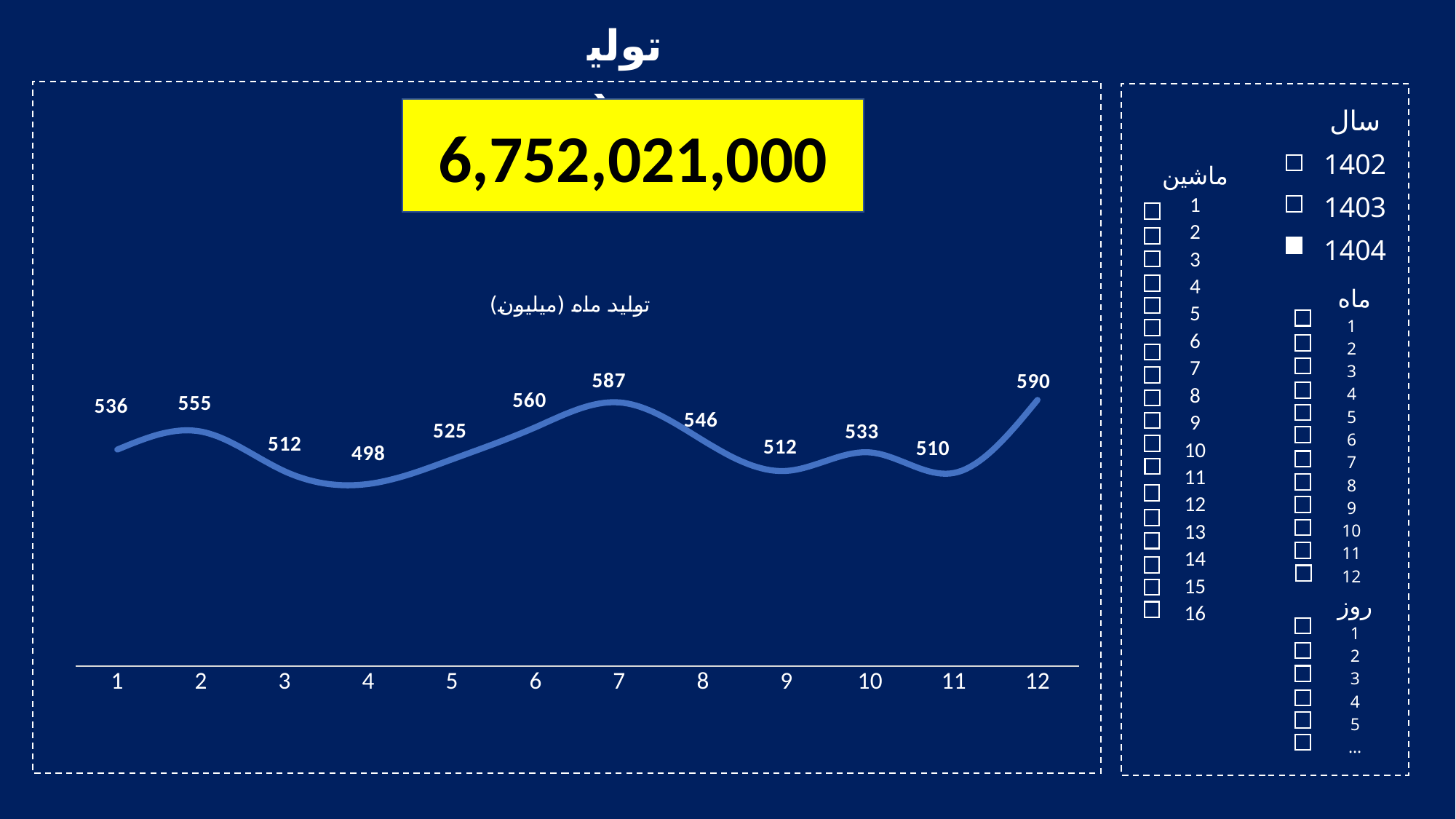
What is the title of the chart? تولید ماه (میلیون) Which is larger, the value for month 2 or the value for month 8? month 2 What is the difference between the values for month 12 and month 11? 80 Which month has the highest value on the line chart? 12 What is the difference between the values for month 7 and month 4? 89 How many months are plotted on the line chart? 12 Which is larger, the value for month 6 or the value for month 10? month 6 What kind of chart is shown on the slide? line chart What is the value for month 1 on the line chart? 536 Which month has the lowest value on the line chart? 4 What is the value for month 4 on the line chart? 498 What is the value for month 7 on the line chart? 587